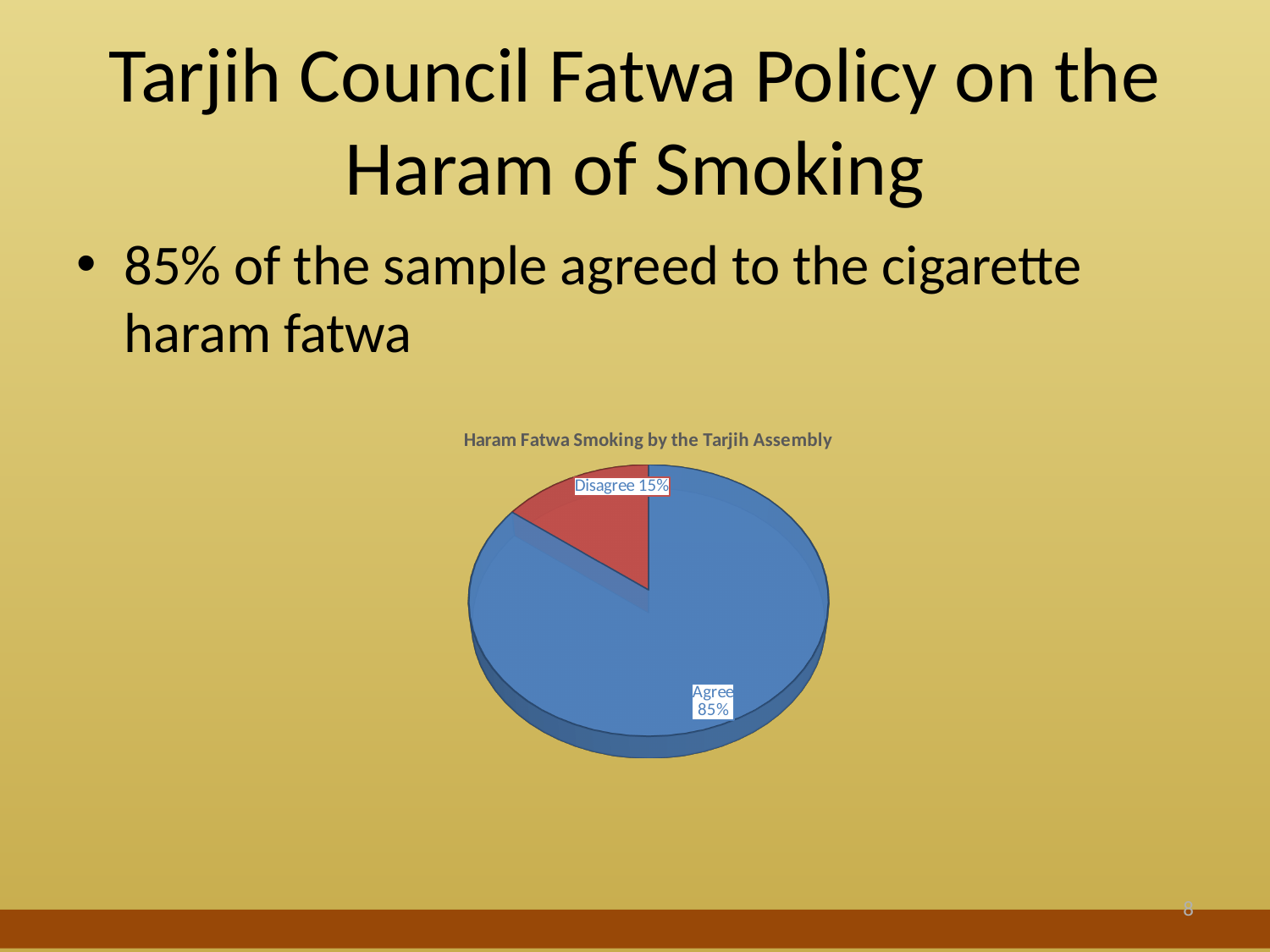
How many slices does the pie chart have? 2 What is the chart's title? Haram Fatwa Smoking by the Tarjih Assembly What kind of chart is shown on the slide? pie chart What percentage of the pie is labelled Disagree? 15% What percentage of the pie is labelled Agree? 85% Which is larger, the Agree slice or the Disagree slice? Agree What colour is the Disagree slice? red Which slice of the pie is the largest? Agree What is the difference in percentage points between the Agree and Disagree slices? 70 Which slice of the pie is the smallest? Disagree What share of the pie does the Agree slice take? 85%